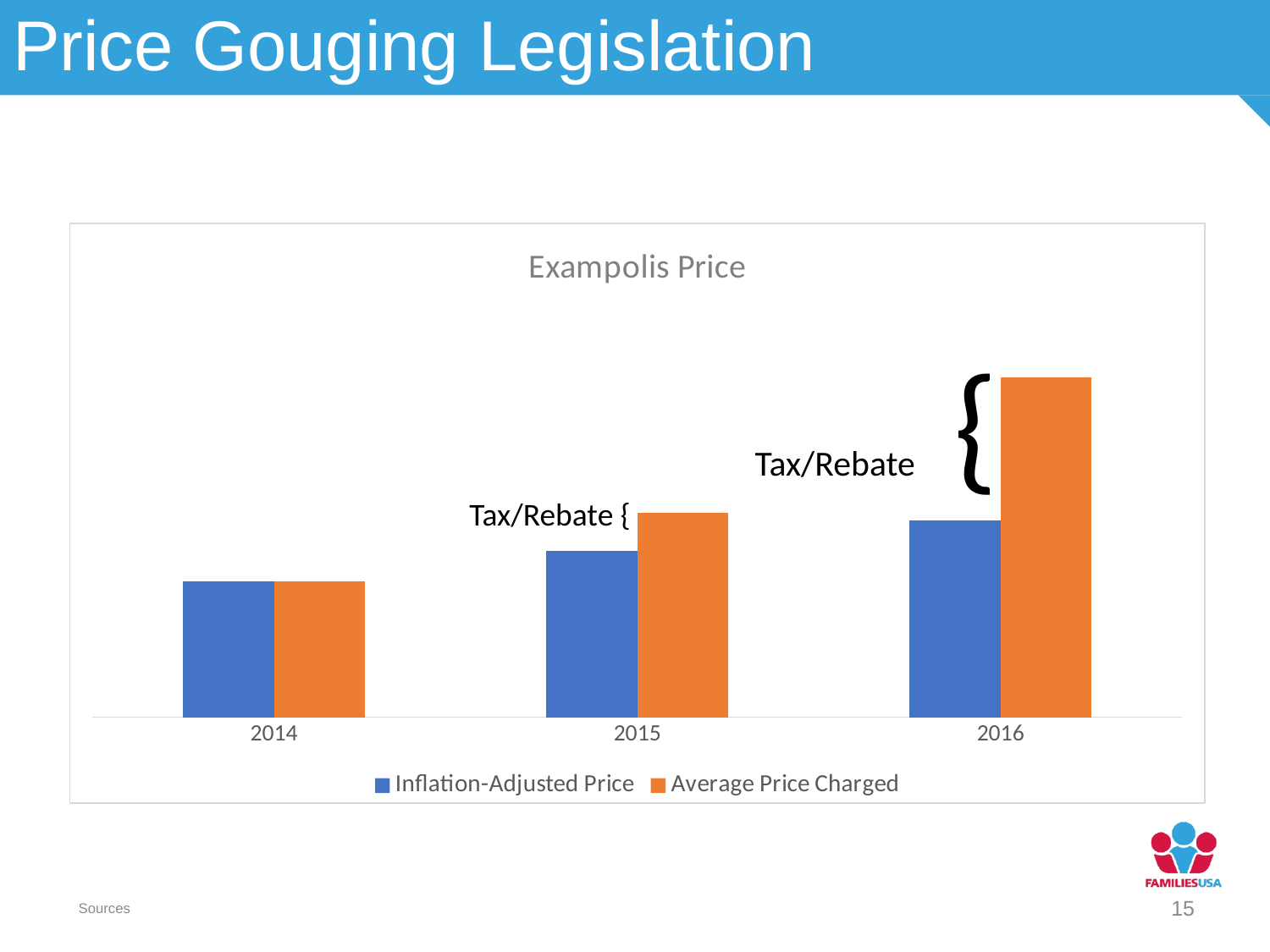
Does the Inflation-Adjusted Price rise or fall from 2014 to 2016? Rise In which year is the Average Price Charged highest? 2016 Is the Average Price Charged larger in 2015 or in 2014? 2015 In which year is the gap between the Average Price Charged and the Inflation-Adjusted Price the largest? 2016 What is the title of the chart? Exampolis Price Does the Average Price Charged rise or fall from 2014 to 2016? Rise In which year is the Inflation-Adjusted Price lowest? 2014 What colour represents the Average Price Charged series in the chart? Orange How many years are shown on the x axis of the chart? 3 How many series does the chart's legend list? 2 What kind of chart is shown on the slide? Bar chart In 2016, which is larger: the Inflation-Adjusted Price or the Average Price Charged? Average Price Charged